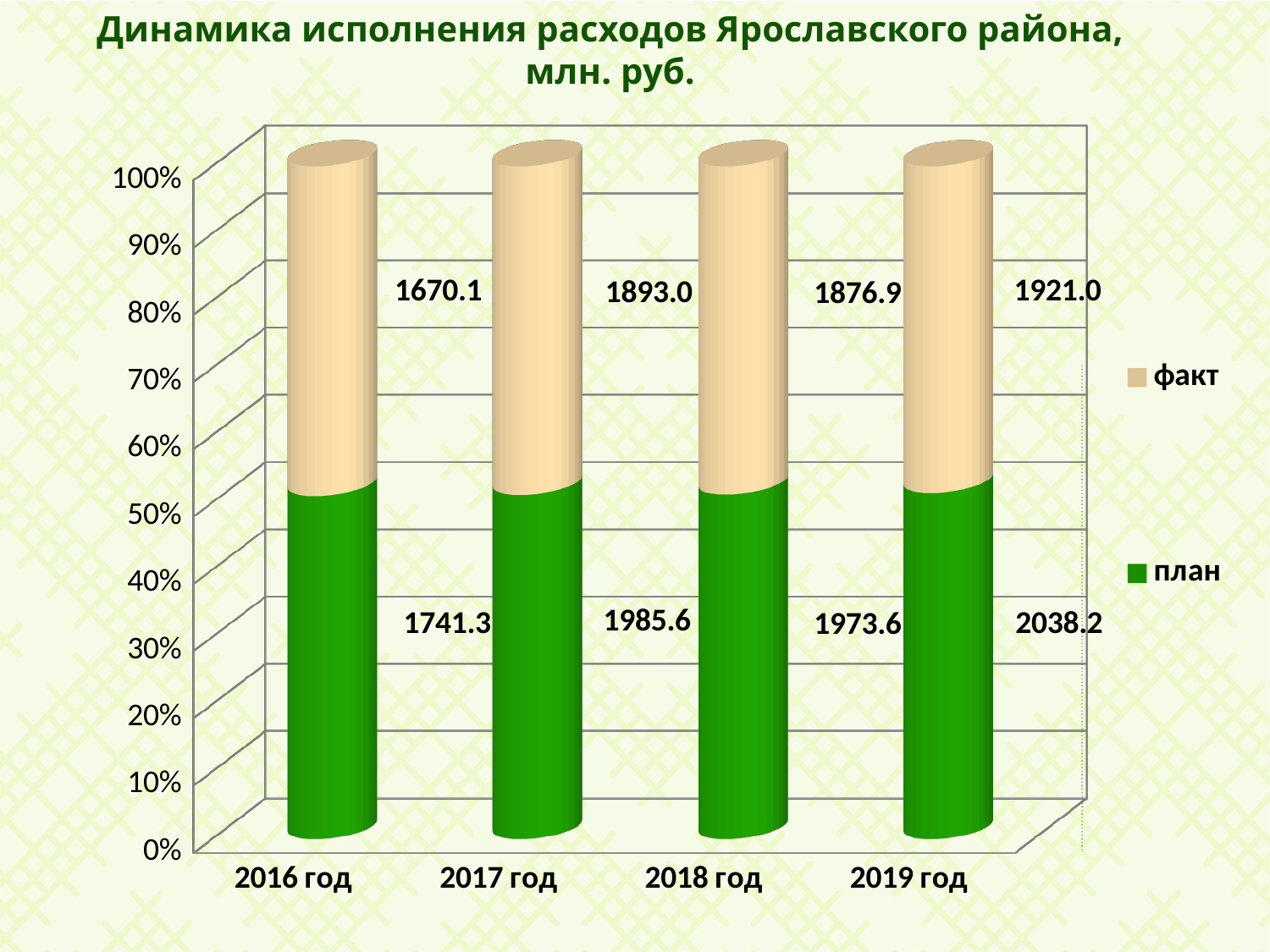
How many years are shown on the x axis? 4 How many series does the legend list? 2 What is the факт value for 2018 год? 1876.9 Which colour represents the план series? green Which is larger, the факт value for 2017 год or for 2018 год? 2017 год What kind of chart is shown on the slide? stacked bar chart What is the difference between план and факт for 2016 год? 71.2 In which year is the факт value lowest? 2016 год What is the план value for 2017 год? 1985.6 What is the difference between план and факт for 2019 год? 117.2 What is the факт value for 2016 год? 1670.1 In which year is the план value highest? 2019 год